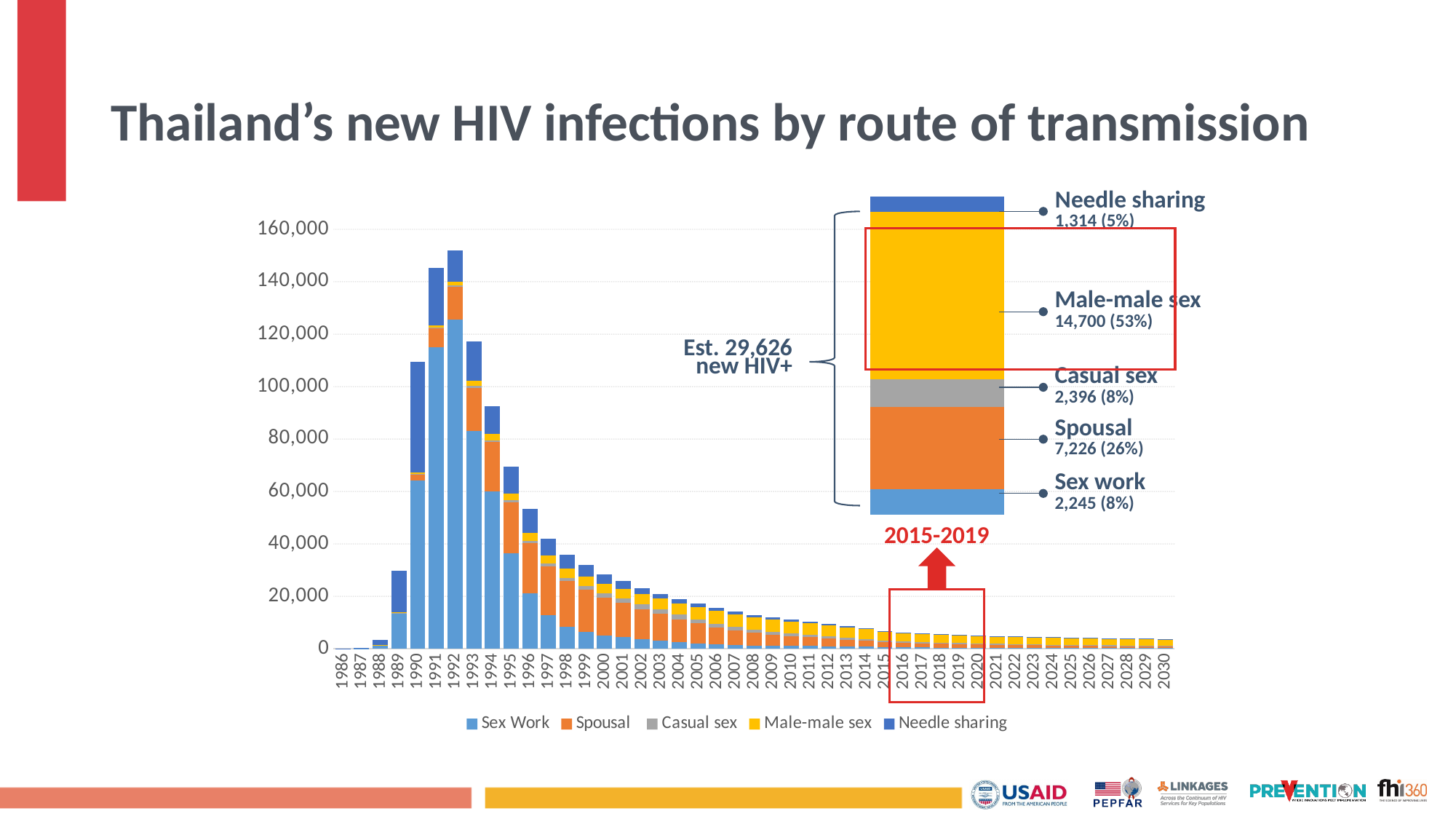
In the 2015-2019 callout, how many new HIV infections are attributed to male-male sex? 14,700 (53%) Which route of transmission accounts for the fewest new HIV infections in the 2015-2019 callout? Needle sharing Which route of transmission accounts for the most new HIV infections in the 2015-2019 callout? Male-male sex In the 2015-2019 callout, how many new HIV infections are attributed to spousal transmission? 7,226 (26%) What share of new HIV infections in 2015-2019 is attributed to male-male sex? 53% What kind of chart is shown on the slide? Stacked bar chart In the 2015-2019 callout, how many new HIV infections are attributed to needle sharing? 1,314 (5%) Is the total value of the 1992 bar greater or less than 140,000? greater In the 2015-2019 callout, what is the difference between the male-male sex and spousal values? 7,474 How many series does the legend list? 5 What is the estimated total number of new HIV infections for 2015-2019 shown on the slide? 29,626 Do the total new HIV infections rise or fall along the x axis from 1992 to 2030? fall